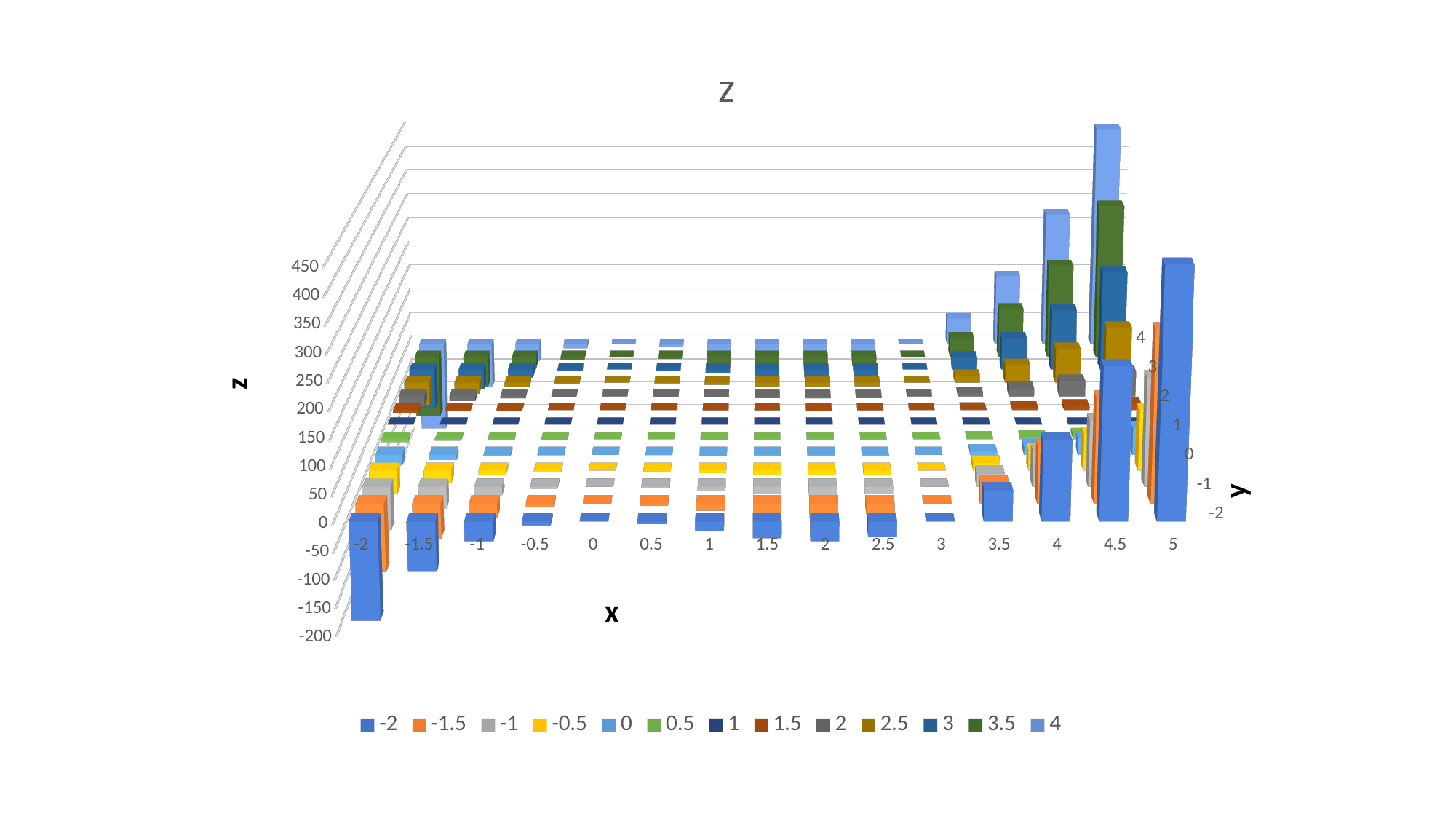
For the series -2, is the value at x = -2 greater or less than -50? less For the series -2, which x category has the highest value? 5 What kind of chart is shown on the slide? 3D bar chart For the series -2, is the value at x = 4 greater or less than 50? greater For the series -2, is the value at x = 4.5 greater or less than 100? greater How many series does the legend list? 13 How many categories are shown along the x axis? 15 What is the title of the chart? Z For the series -2, do the values rise or fall from x = 3.5 to x = 5? rise For the series -2, which is larger: the value at x = 5 or the value at x = 4? x = 5 What is the label of the first entry in the legend? -2 For the series -2, which x category has the lowest value? -2